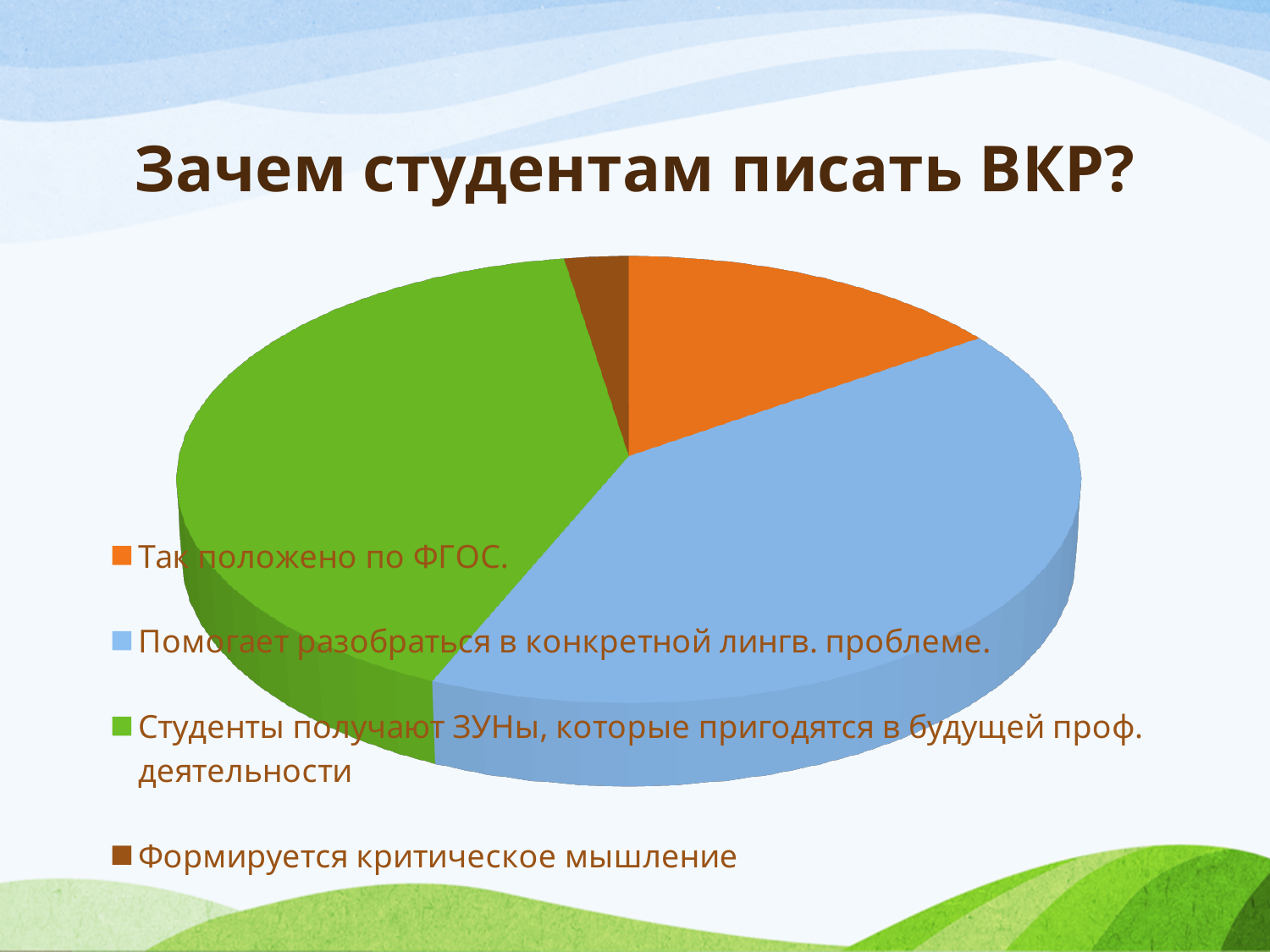
How many entries does the legend of the pie chart list? 4 How many slices does the pie chart have? 4 Which slice is larger: "Так положено по ФГОС." or "Формируется критическое мышление"? Так положено по ФГОС. Which category has the smallest slice of the pie chart? Формируется критическое мышление Which slice is larger: "Студенты получают ЗУНы, которые пригодятся в будущей проф. деятельности" or "Так положено по ФГОС."? Студенты получают ЗУНы, которые пригодятся в будущей проф. деятельности What is the title of the slide containing the pie chart? Зачем студентам писать ВКР? What kind of chart is shown on the slide? Pie chart Which slice is larger: "Так положено по ФГОС." or "Помогает разобраться в конкретной лингв. проблеме."? Помогает разобраться в конкретной лингв. проблеме. What colour is the slice for "Так положено по ФГОС." in the pie chart? Orange